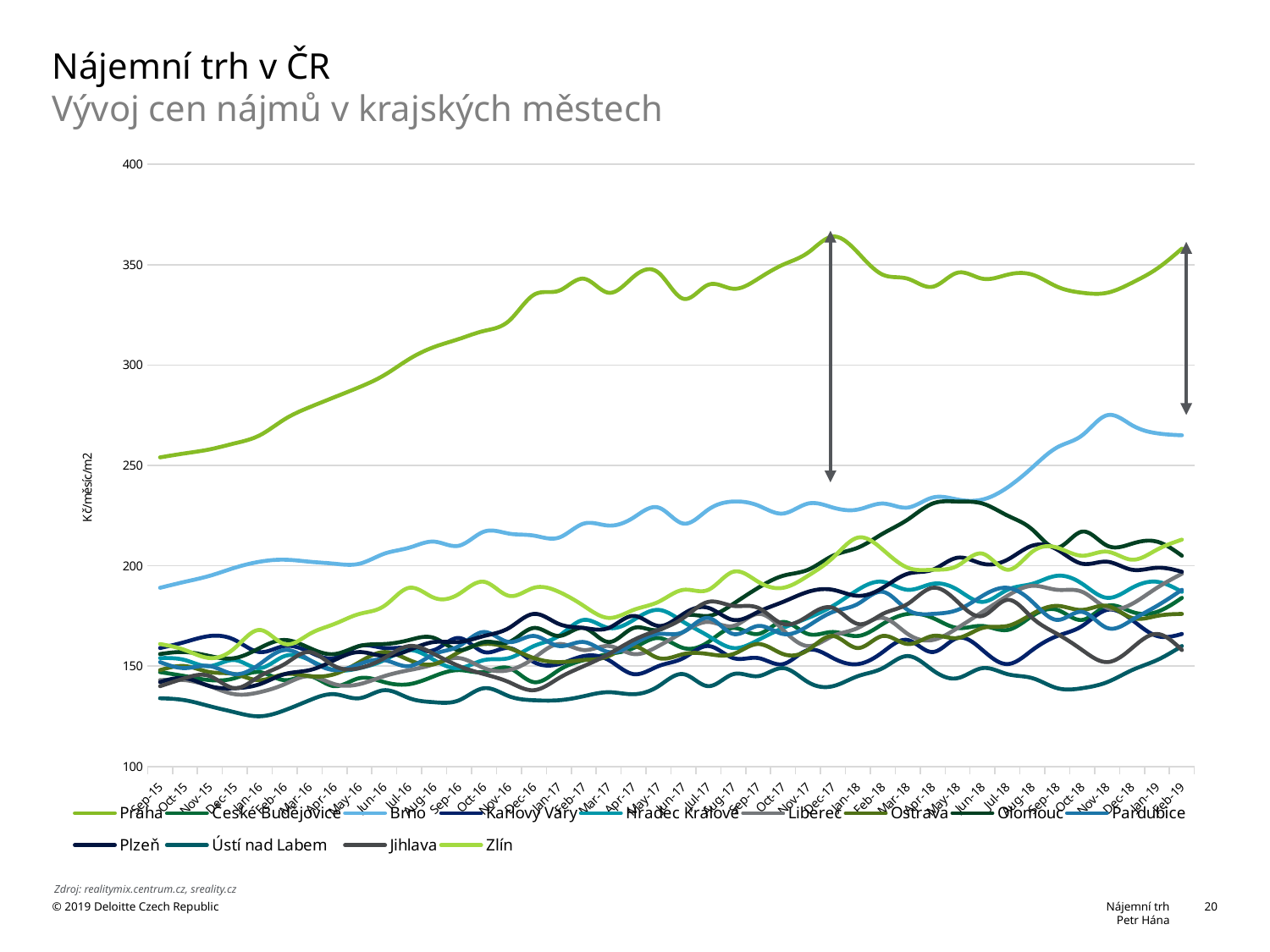
Is the value for Brno in Feb-19 greater or less than 250? greater What kind of chart is shown on the slide? line chart Is the value for Praha in Dec-17 greater or less than 350? greater What is the label on the vertical axis? Kč/měsíc/m2 How many series does the legend list? 13 Which city has the second-highest rent prices at the end of the period (Feb-19)? Brno Does the Praha line generally rise or fall from Sep-15 to Feb-19? rise Which city has the highest rent prices throughout the period shown? Praha Is the value for Praha in Sep-15 greater or less than 300? less Which is larger in Feb-19, the value for Praha or the value for Brno? Praha What is the subtitle of the chart on the slide? Vývoj cen nájmů v krajských městech